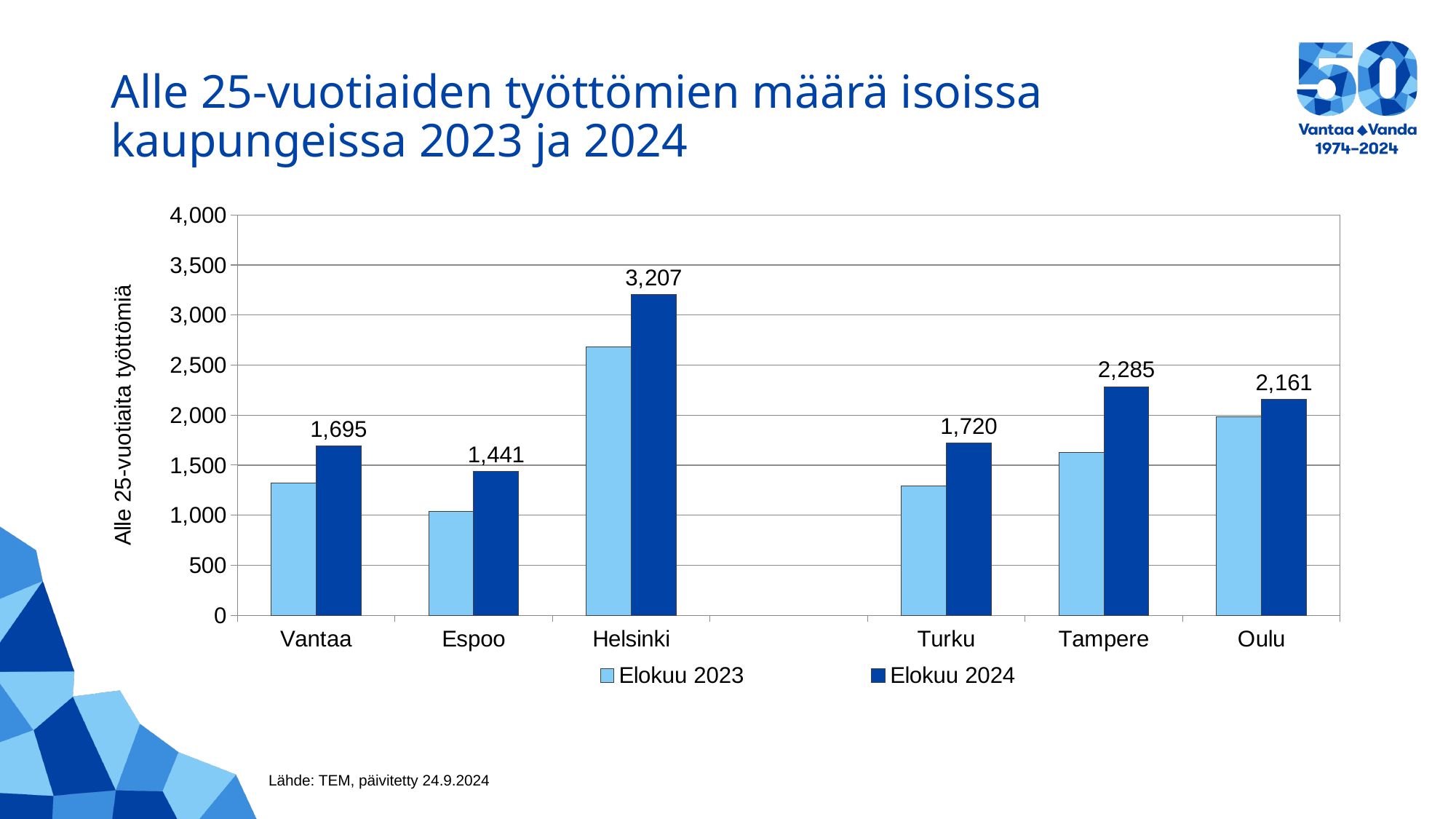
How many cities are shown on the x axis? 6 Which city has the lowest value in the Elokuu 2024 series? Espoo Is the Elokuu 2023 value for Helsinki greater or less than 2,500? greater Which city has the highest value in the Elokuu 2024 series? Helsinki What is the value for Helsinki in the Elokuu 2024 series? 3,207 How many series does the legend list? 2 Is the Elokuu 2023 value for Vantaa greater or less than 1,500? less What is the value for Espoo in the Elokuu 2024 series? 1,441 What kind of chart is shown on the slide? Bar chart Which is larger in the Elokuu 2024 series: Vantaa or Turku? Turku What is the value for Tampere in the Elokuu 2024 series? 2,285 What is the difference between the Elokuu 2024 values for Tampere and Oulu? 124